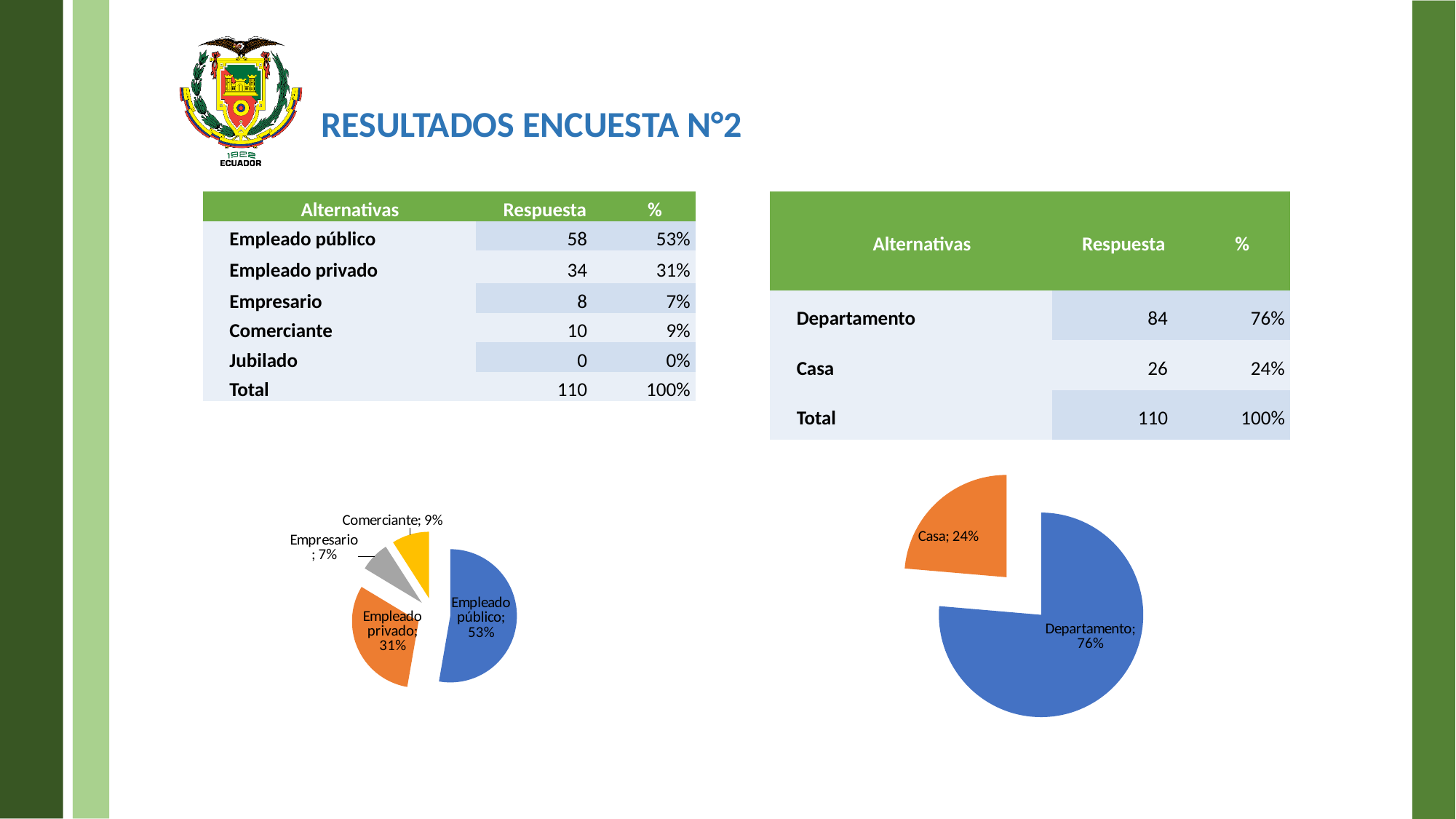
In the pie chart on the right, what share is labelled for Casa? 24% In the pie chart on the left, what share is labelled for Empresario? 7% In the pie chart on the left, how many labelled slices are there? 4 In the pie chart on the right, which slice is larger, Departamento or Casa? Departamento In the pie chart on the left, what share is labelled for Comerciante? 9% In the pie chart on the right, what share is labelled for Departamento? 76% In the pie chart on the left, which labelled category has the smallest slice? Empresario What type of chart is shown on the right side of the slide? Pie chart In the pie chart on the left, which category has the largest slice? Empleado público In the pie chart on the left, what is the difference in percentage points between Empleado público and Empleado privado? 22 In the pie chart on the left, what share is labelled for Empleado privado? 31% In the pie chart on the left, what share is labelled for Empleado público? 53%